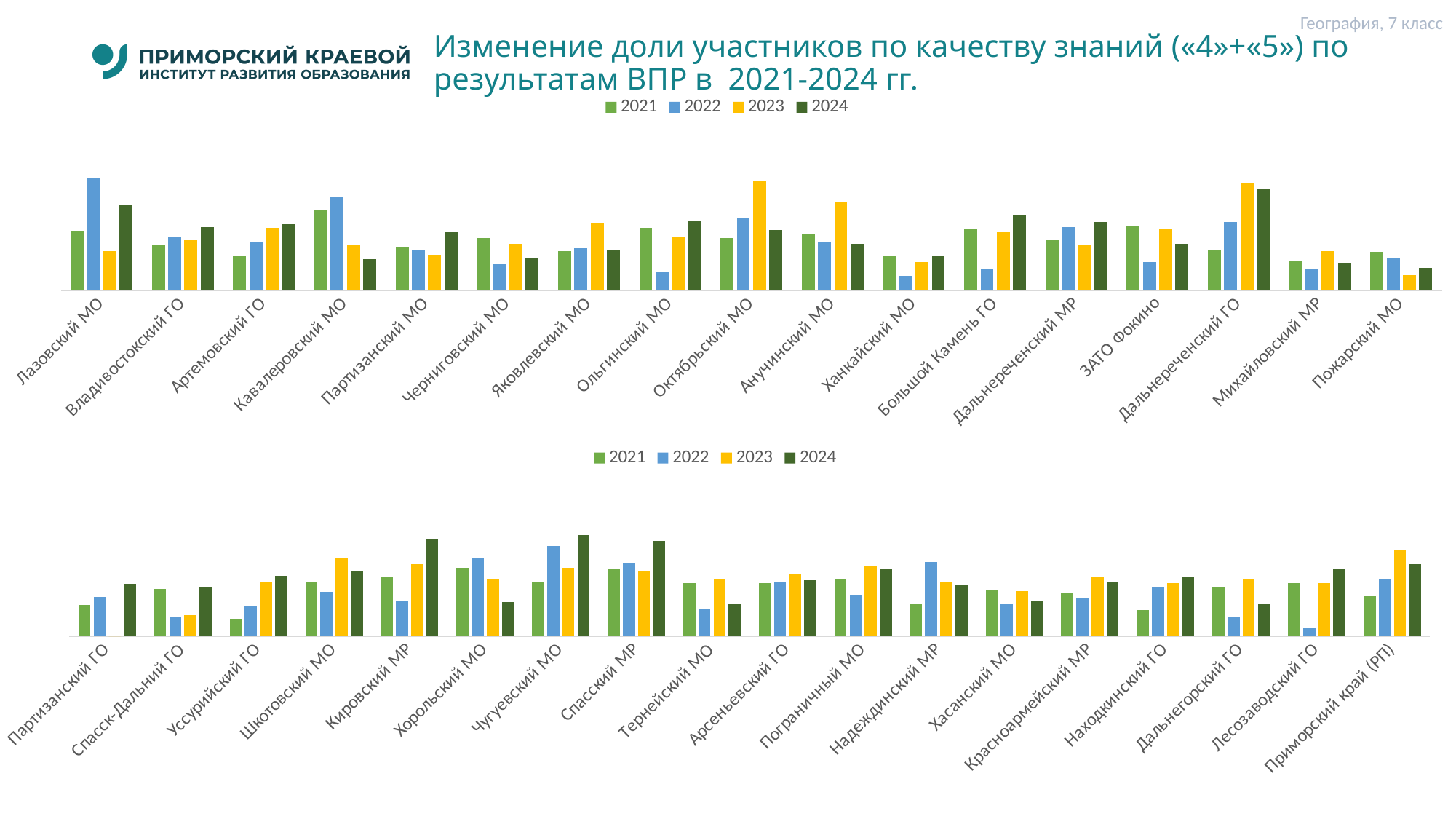
In the top chart, which category has the highest value for the 2022 series? Лазовский МО In the top chart, for Ханкайский МО, which year has the lowest value? 2022 In the bottom chart, for Лесозаводский ГО, which is larger: the 2022 value or the 2024 value? 2024 In the bottom chart, which category has the highest value for the 2022 series? Чугуевский МО What kind of chart is the top chart on the slide? bar chart In the top chart, for Кавалеровский МО, which year has the lowest value? 2024 How many categories are shown on the x axis of the bottom chart? 18 How many series does the legend of the top chart list? 4 In the bottom chart, which category has the lowest value for the 2022 series? Лесозаводский ГО How many categories are shown on the x axis of the top chart? 17 In the top chart, for Лазовский МО, which is larger: the 2022 value or the 2023 value? 2022 Which years are listed in the legend of the bottom chart? 2021, 2022, 2023, 2024